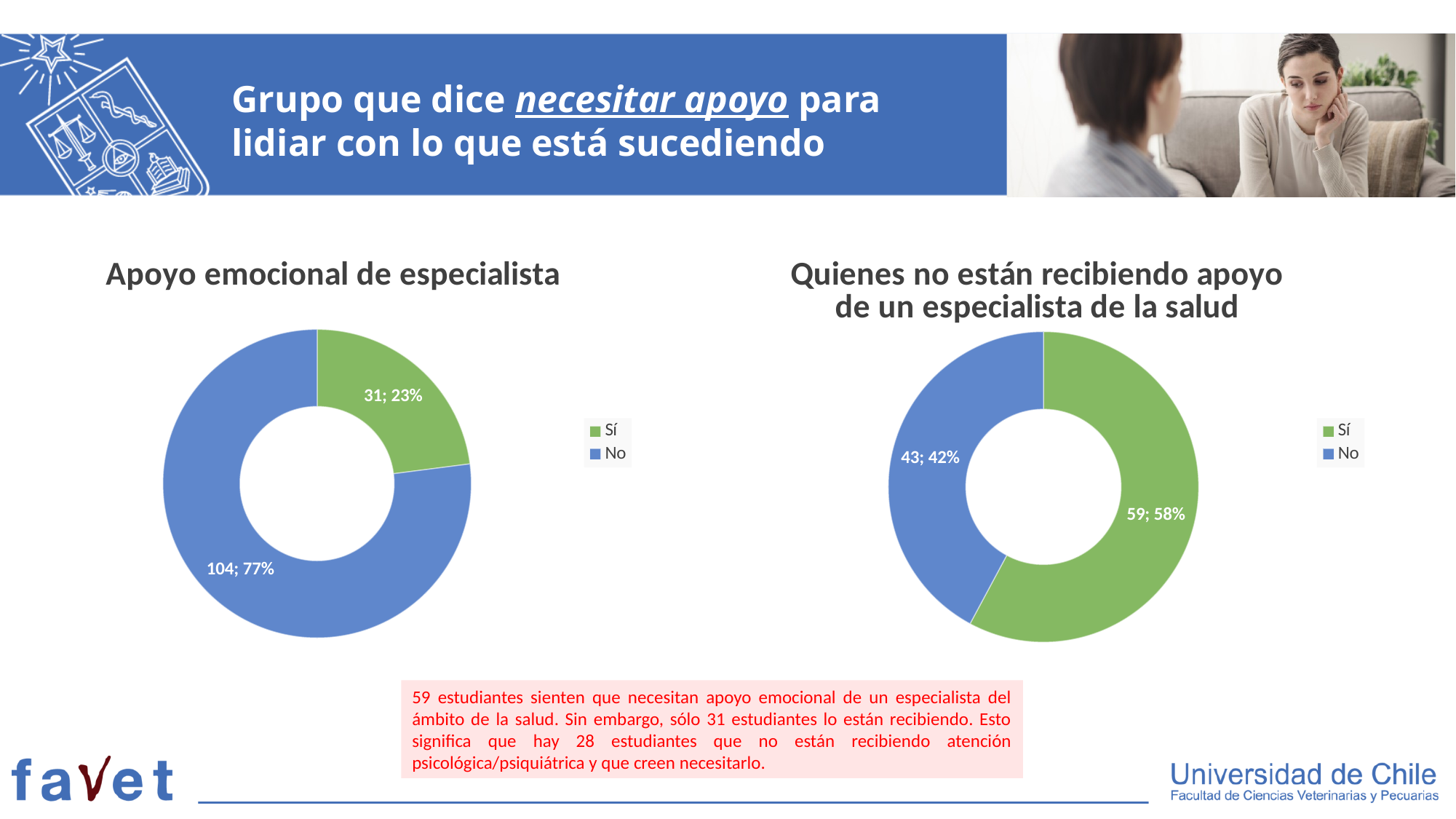
How many categories does the legend of the chart titled 'Apoyo emocional de especialista' list? 2 In the chart titled 'Quienes no están recibiendo apoyo de un especialista de la salud', what percentage of respondents answered 'No'? 42% In the chart titled 'Quienes no están recibiendo apoyo de un especialista de la salud', which category is the largest? Sí In the chart titled 'Apoyo emocional de especialista', how many respondents answered 'Sí'? 31 In the chart titled 'Quienes no están recibiendo apoyo de un especialista de la salud', what is the total number of responses? 102 In the chart titled 'Quienes no están recibiendo apoyo de un especialista de la salud', how many respondents answered 'Sí'? 59 In the chart titled 'Apoyo emocional de especialista', which category has the larger share, 'Sí' or 'No'? No In the chart titled 'Apoyo emocional de especialista', what is the difference between the number of 'No' and 'Sí' responses? 73 In the chart titled 'Apoyo emocional de especialista', what is the total number of responses across both categories? 135 In the chart titled 'Apoyo emocional de especialista', what percentage of respondents answered 'No'? 77% What type of chart is used on the left side of the slide, titled 'Apoyo emocional de especialista'? Doughnut (pie) chart In the chart titled 'Quienes no están recibiendo apoyo de un especialista de la salud', what is the difference between the 'Sí' and 'No' counts? 16